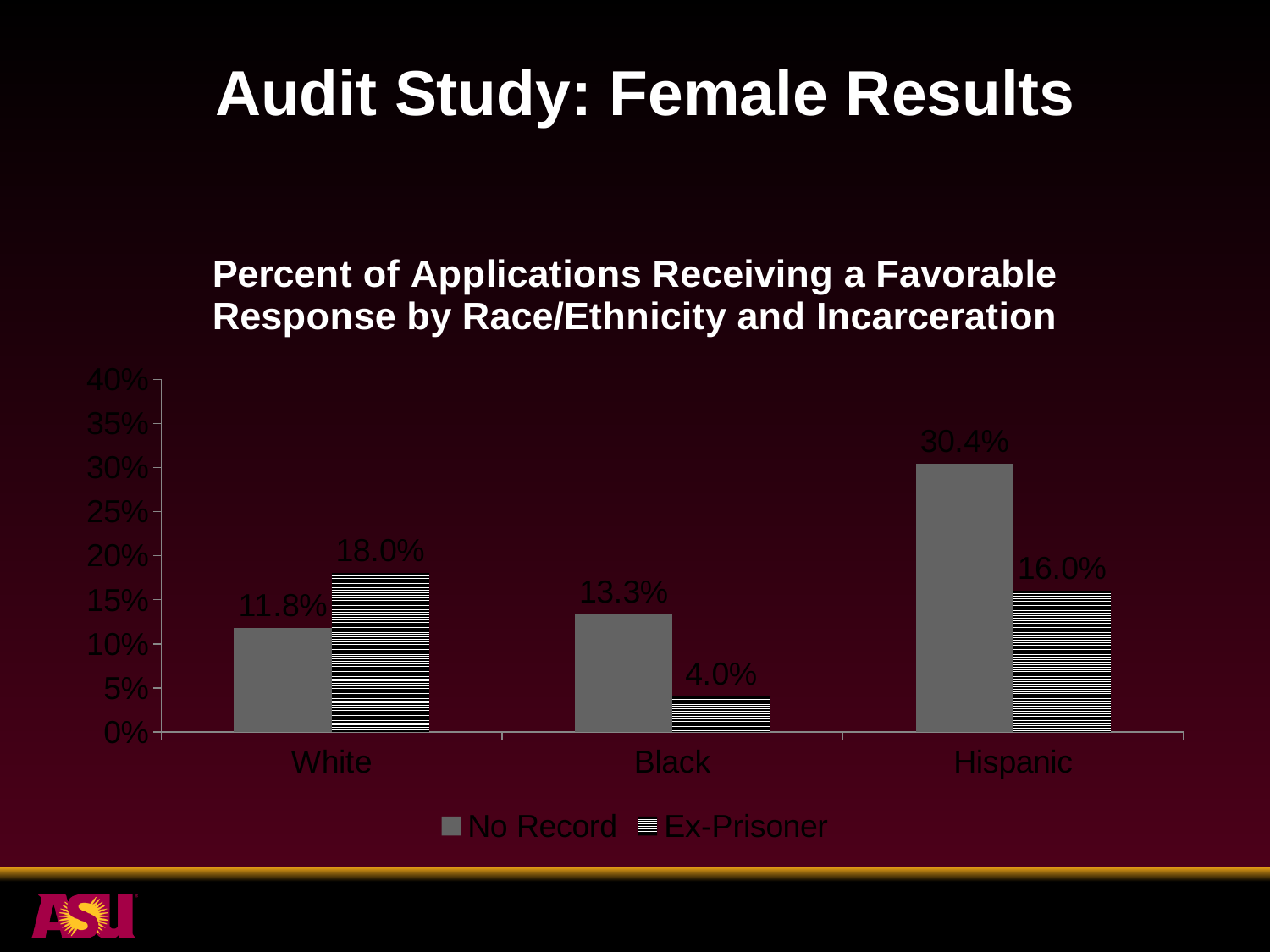
Is the No Record value for Black applicants greater or less than 15%? less For White applicants, which is larger: the No Record value or the Ex-Prisoner value? Ex-Prisoner How many series does the legend list? 2 What kind of chart is shown on the slide? bar chart Which race/ethnicity has the highest No Record value? Hispanic How many race/ethnicity categories are shown on the x axis? 3 What is the No Record value for Hispanic applicants? 30.4% What is the Ex-Prisoner value for White applicants? 18.0% What is the difference between the No Record and Ex-Prisoner values for Hispanic applicants? 14.4% What is the difference between the Ex-Prisoner and No Record values for White applicants? 6.2% What is the Ex-Prisoner value for Black applicants? 4.0% Which race/ethnicity has the lowest Ex-Prisoner value? Black